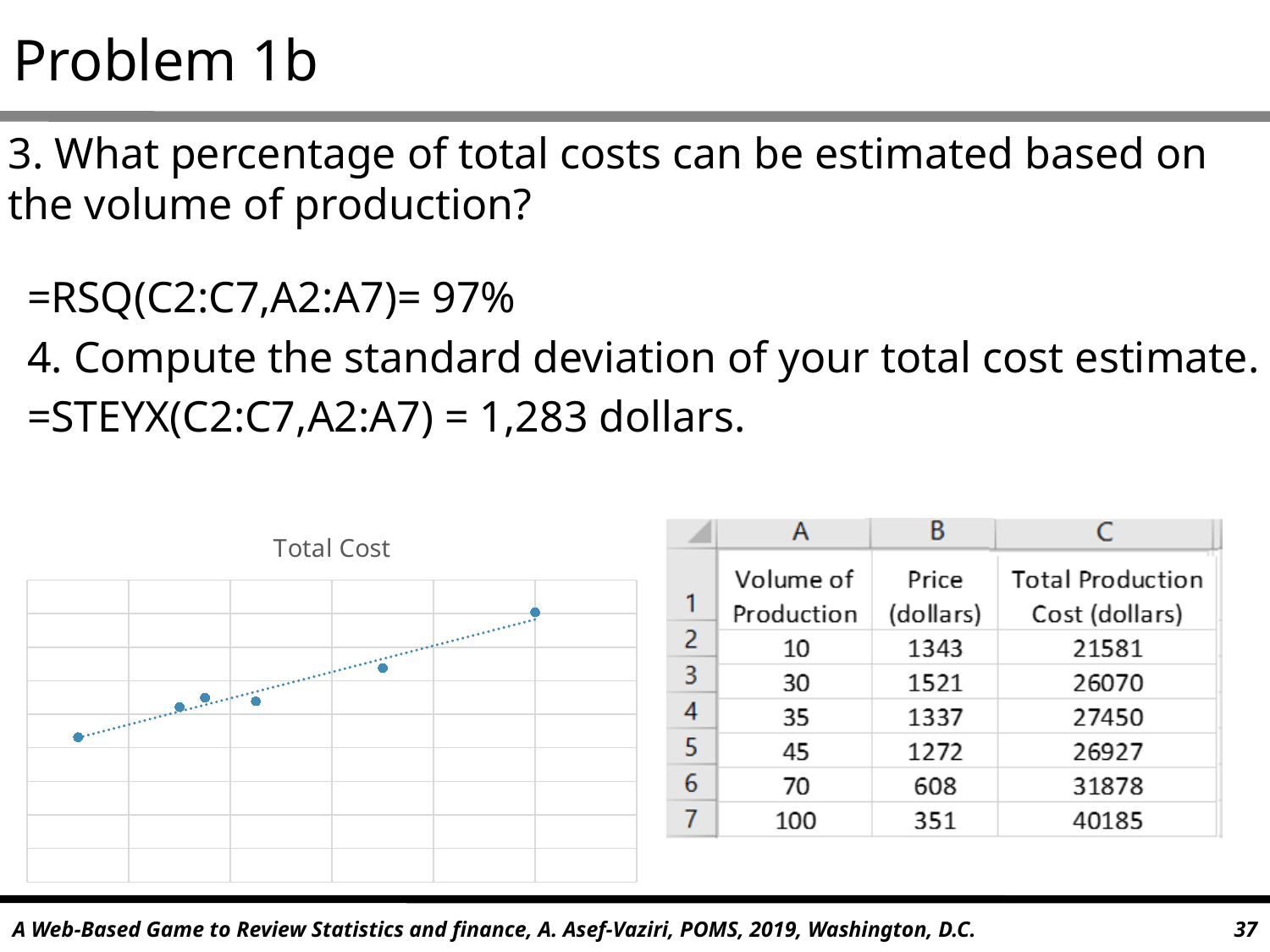
In the "Total Cost" chart, is the highest point the leftmost or the rightmost point? rightmost Does the "Total Cost" chart show a legend? No In the "Total Cost" chart, is the lowest point the leftmost or the rightmost point? leftmost What kind of chart is the "Total Cost" chart? scatter chart In the "Total Cost" chart, which is higher: the fifth point from the left or the fourth point from the left? the fifth point In the "Total Cost" chart, which is higher: the rightmost point or the leftmost point? the rightmost point What is the title of the chart on the slide? Total Cost How many data points are plotted in the "Total Cost" chart? 6 Do the plotted values in the "Total Cost" chart generally rise or fall from left to right? rise What style of line is drawn through the points in the "Total Cost" chart? a dotted trendline